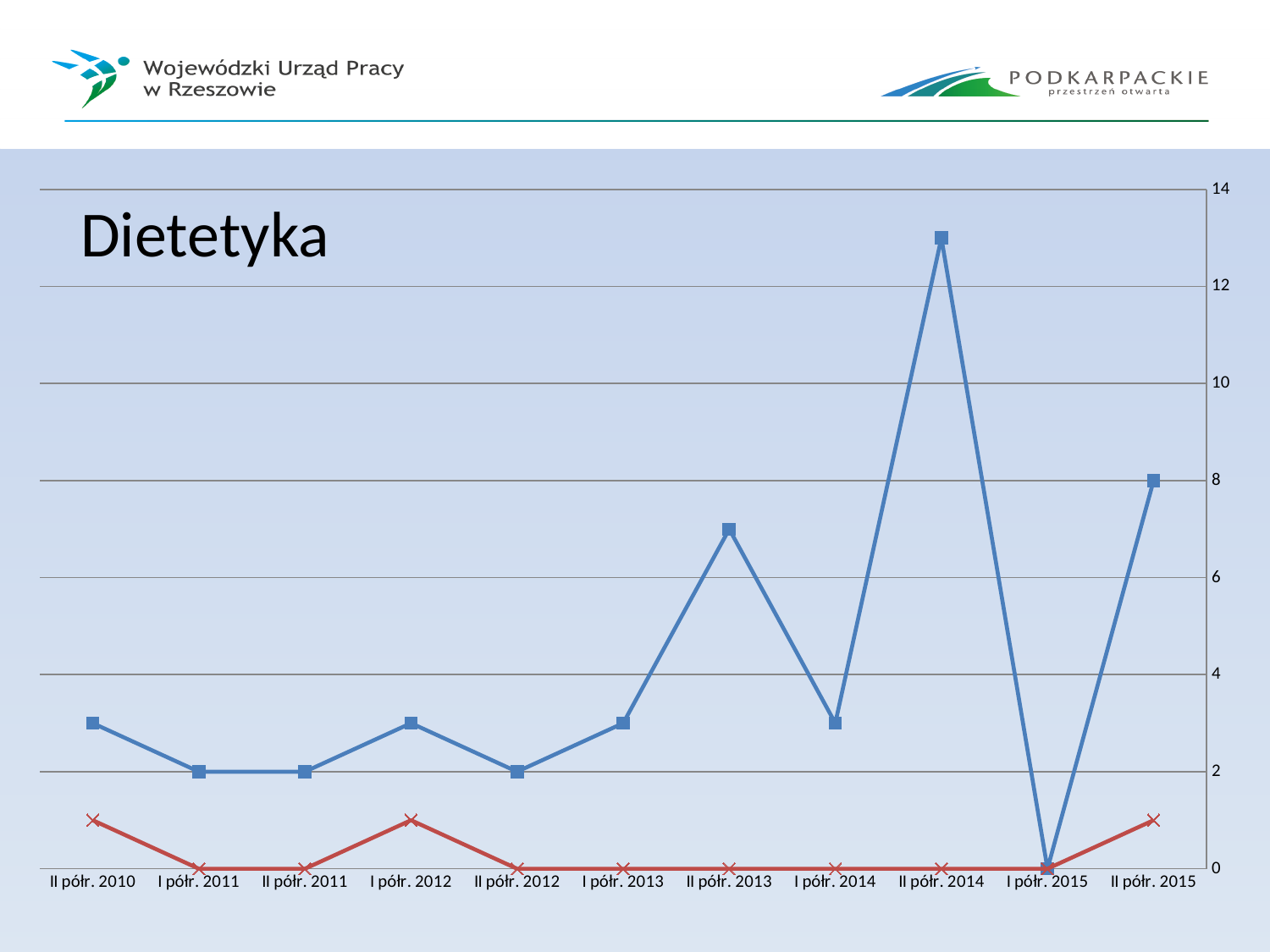
In which period does the blue line reach its highest value? II półr. 2014 What kind of chart is shown on the slide? line chart Is the value of the blue line for II półr. 2013 greater or less than 6? greater What is the value of the red line for II półr. 2012? 0 How many lines are plotted on the chart? 2 Which period has the larger value on the blue line: II półr. 2013 or I półr. 2014? II półr. 2013 How many categories are shown on the x axis? 11 What is the value of the blue line for I półr. 2015? 0 What is the value of the blue line for II półr. 2015? 8 Is the value of the blue line for II półr. 2014 greater or less than 12? greater What is the value of the blue line for I półr. 2011? 2 What is the title of the chart? Dietetyka